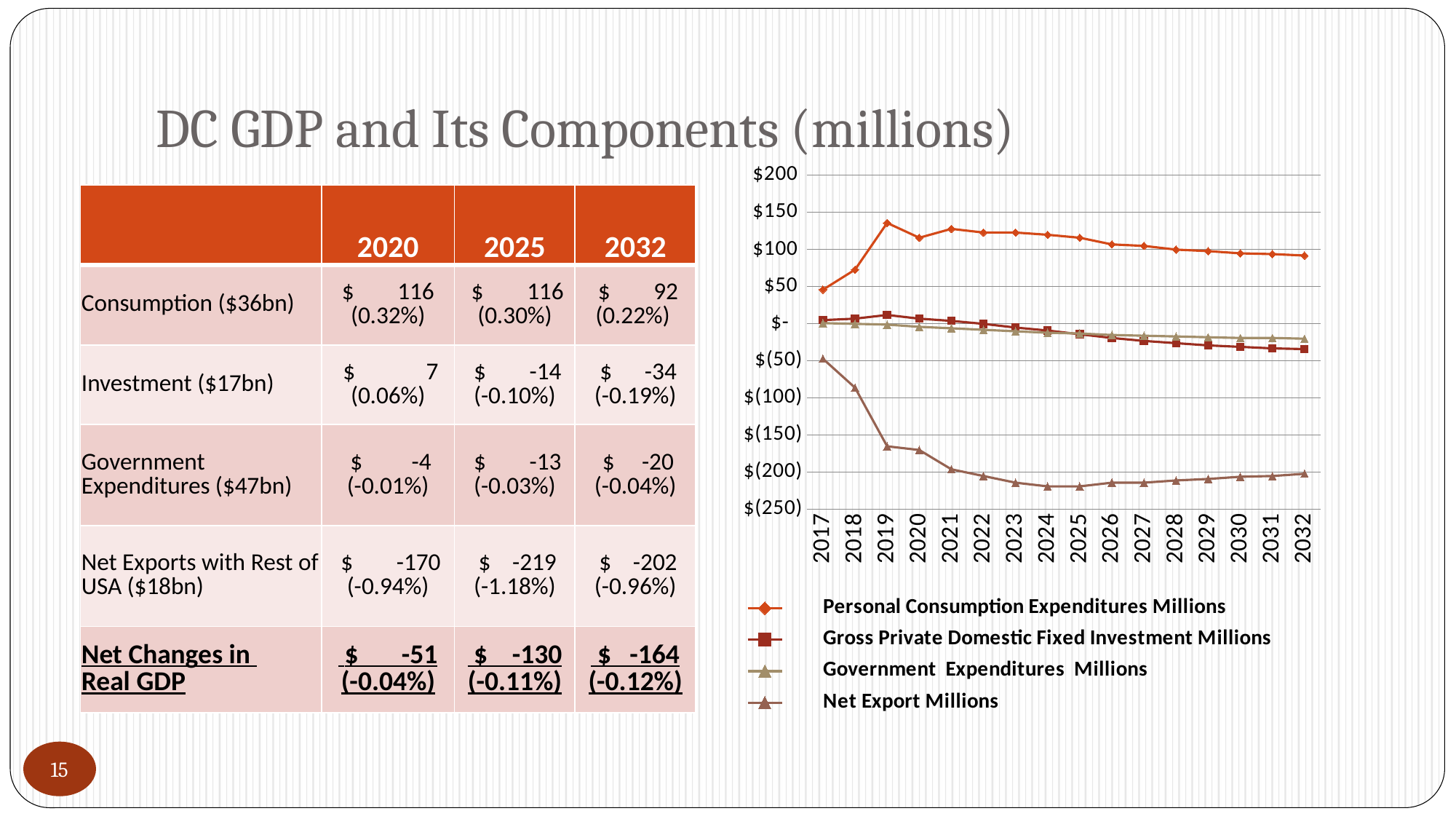
How many series does the chart's legend list? 4 In which year does Personal Consumption Expenditures Millions reach its highest value? 2019 In 2032, which is larger: Government Expenditures Millions or Gross Private Domestic Fixed Investment Millions? Government Expenditures Millions How many years are plotted along the x axis of the chart? 16 Is the value for Net Export Millions in 2018 greater or less than $(100)? greater Which series has the lowest values across the whole chart? Net Export Millions Which series has the highest value in 2019? Personal Consumption Expenditures Millions What kind of chart is shown on the right side of the slide? line chart What is the lowest tick shown on the chart's vertical axis? $(250) Is the value for Net Export Millions in 2023 greater or less than $(200)? less Does Personal Consumption Expenditures Millions rise or fall from 2019 to 2032? fall Is the value for Personal Consumption Expenditures Millions in 2019 greater or less than $100? greater